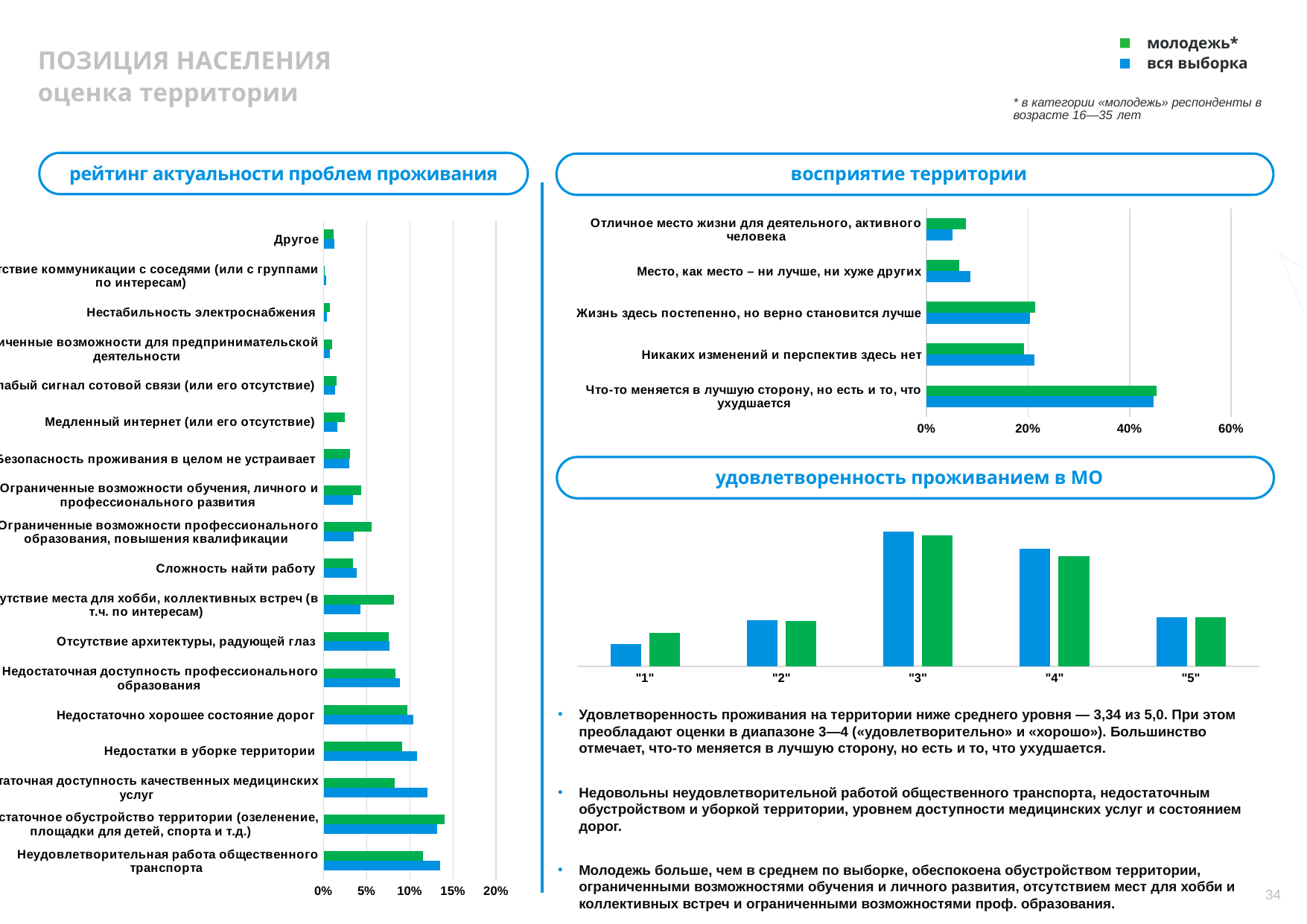
In the "восприятие территории" chart, which category has the highest value for "вся выборка"? Что-то меняется в лучшую сторону, но есть и то, что ухудшается In the "рейтинг актуальности проблем проживания" chart, is the value of "вся выборка" for "Неудовлетворительная работа общественного транспорта" greater or less than 10%? greater Which colour represents the "молодежь" series in the charts? green In the "восприятие территории" chart, is the value of "молодежь" for "Отличное место жизни для деятельного, активного человека" greater or less than 20%? less In the "восприятие территории" chart, how many categories are shown? 5 What kind of chart is the "рейтинг актуальности проблем проживания" chart? bar chart In the "рейтинг актуальности проблем проживания" chart, is the value of "молодежь" for "Сложность найти работу" greater or less than 5%? less In the "удовлетворенность проживанием в МО" chart, which category has the lowest value for "молодежь"? "1" In the "удовлетворенность проживанием в МО" chart, which category has the highest value for "вся выборка"? "3" In the "рейтинг актуальности проблем проживания" chart, which series has the larger value for "Неудовлетворительная работа общественного транспорта"? вся выборка How many series does the legend at the top of the slide list? 2